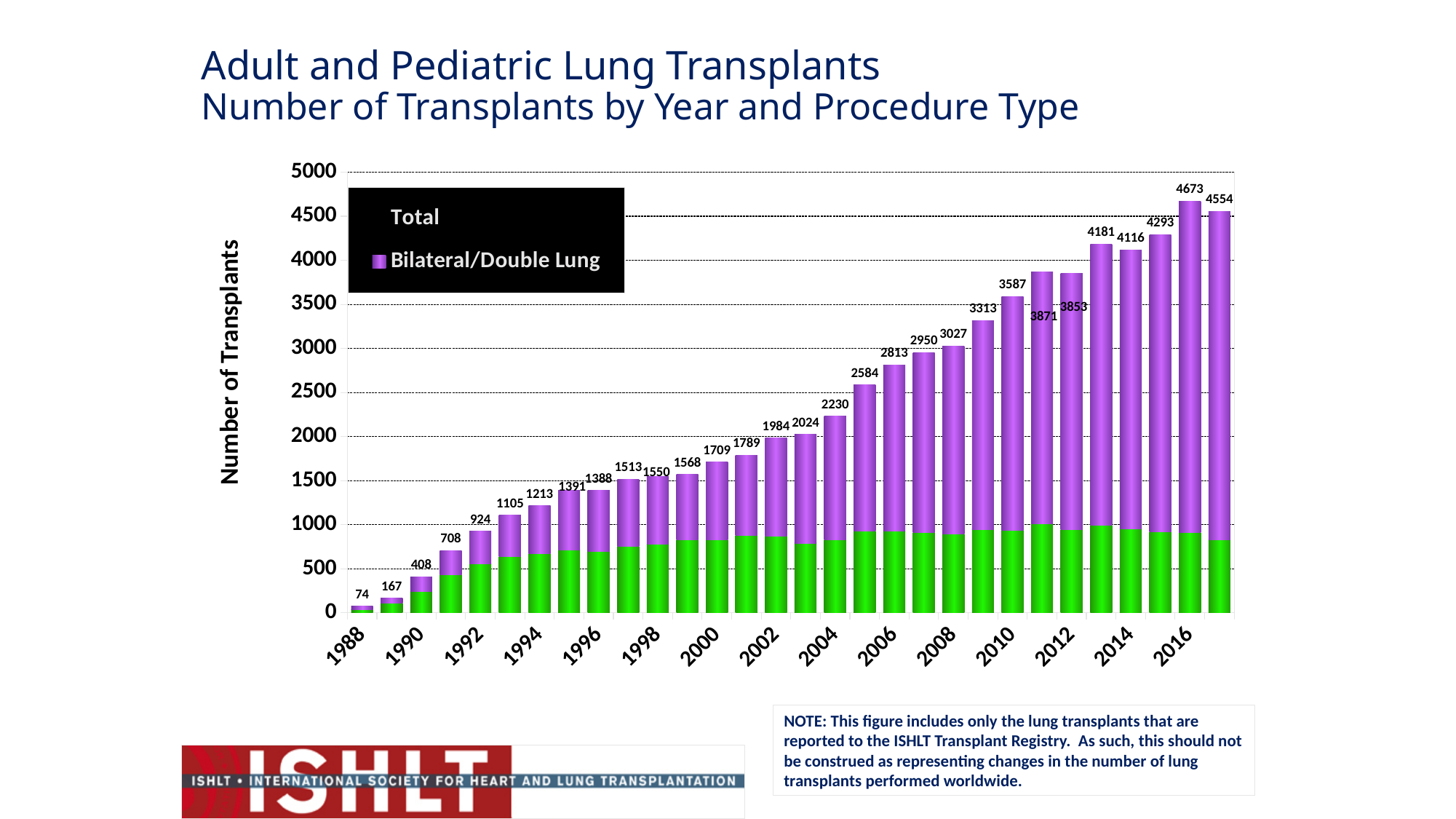
What is the total number of lung transplants shown for 2000? 1709 What is the total number of lung transplants shown for 2010? 3587 Which year has a larger total, 2011 or 2012? 2011 Which year has the highest total number of transplants? 2016 Is the green (bottom) segment of the bar for 2000 greater or less than 1000? less What is the label on the vertical axis of the chart? Number of Transplants Do the total numbers of transplants generally rise or fall from 1988 to 2017? Rise What kind of chart is shown on the slide? Stacked bar chart Which year has the lowest total number of transplants? 1988 How many years (bars) are plotted in the chart? 30 What is the difference between the total for 2016 and the total for 2017? 119 What is the total number of lung transplants shown for 1988? 74